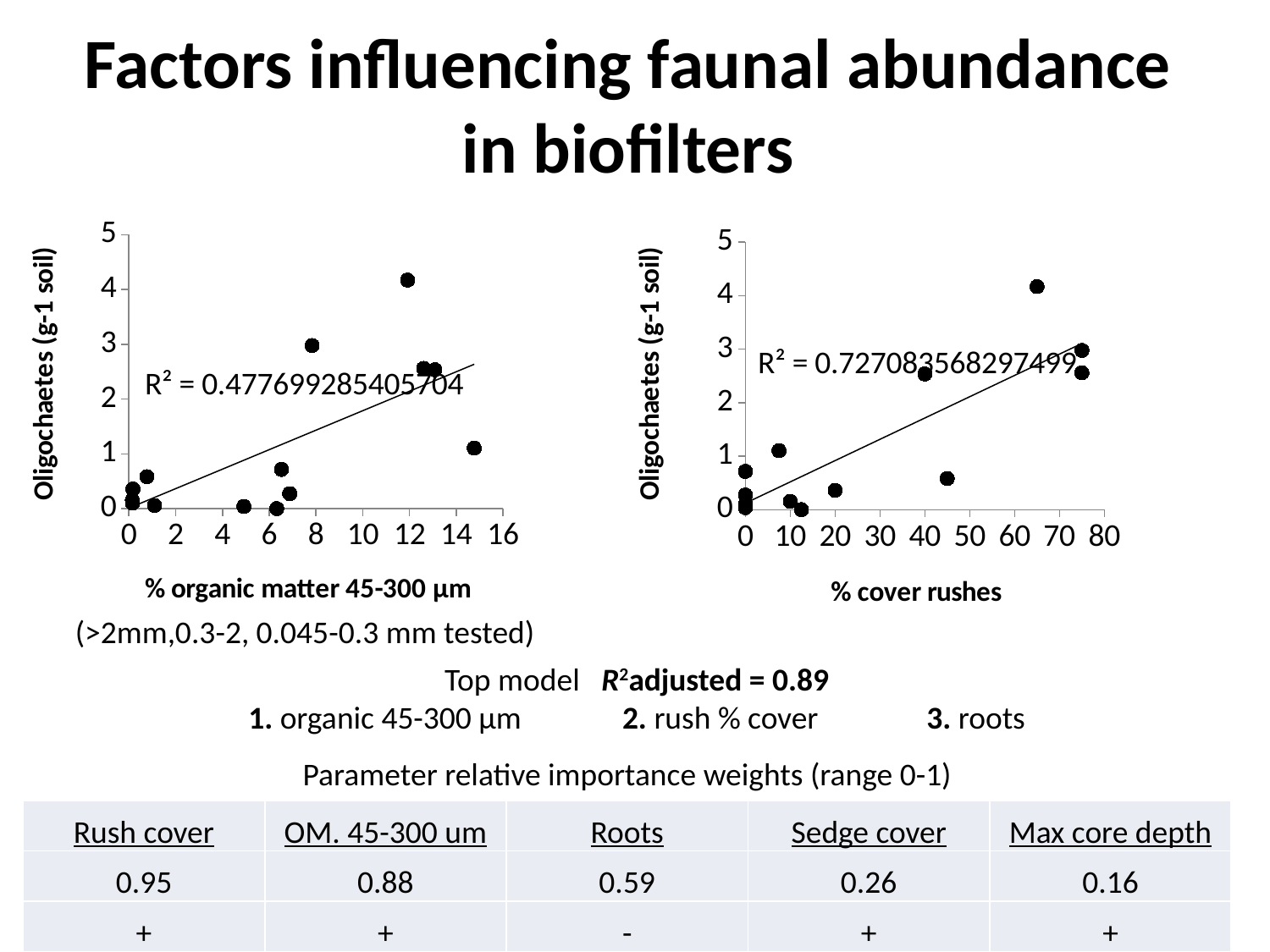
Which chart shows the higher R² value, the left chart (% organic matter 45-300 µm) or the right chart (% cover rushes)? the right chart (% cover rushes) What R² value is printed on the left chart (% organic matter 45-300 µm)? R² = 0.477699285405704 What R² value is printed on the right chart (% cover rushes)? R² = 0.727083568297499 In the right chart (% cover rushes), is the Oligochaetes value of the point at about 45% cover rushes greater or less than 1? less In the right chart (% cover rushes), is the highest plotted Oligochaetes value greater or less than 4? greater In the right chart (% cover rushes), does the fitted trend line rise or fall as the x value increases? rise What is the x-axis label of the right chart? % cover rushes What kind of chart is the left chart with x axis '% organic matter 45-300 µm'? scatter chart What is the y-axis label of the left chart? Oligochaetes (g-1 soil) What kind of chart is the right chart with x axis '% cover rushes'? scatter chart In the left chart (% organic matter 45-300 µm), does the fitted trend line rise or fall as the x value increases? rise In the left chart (% organic matter 45-300 µm), is the highest plotted Oligochaetes value greater or less than 4? greater